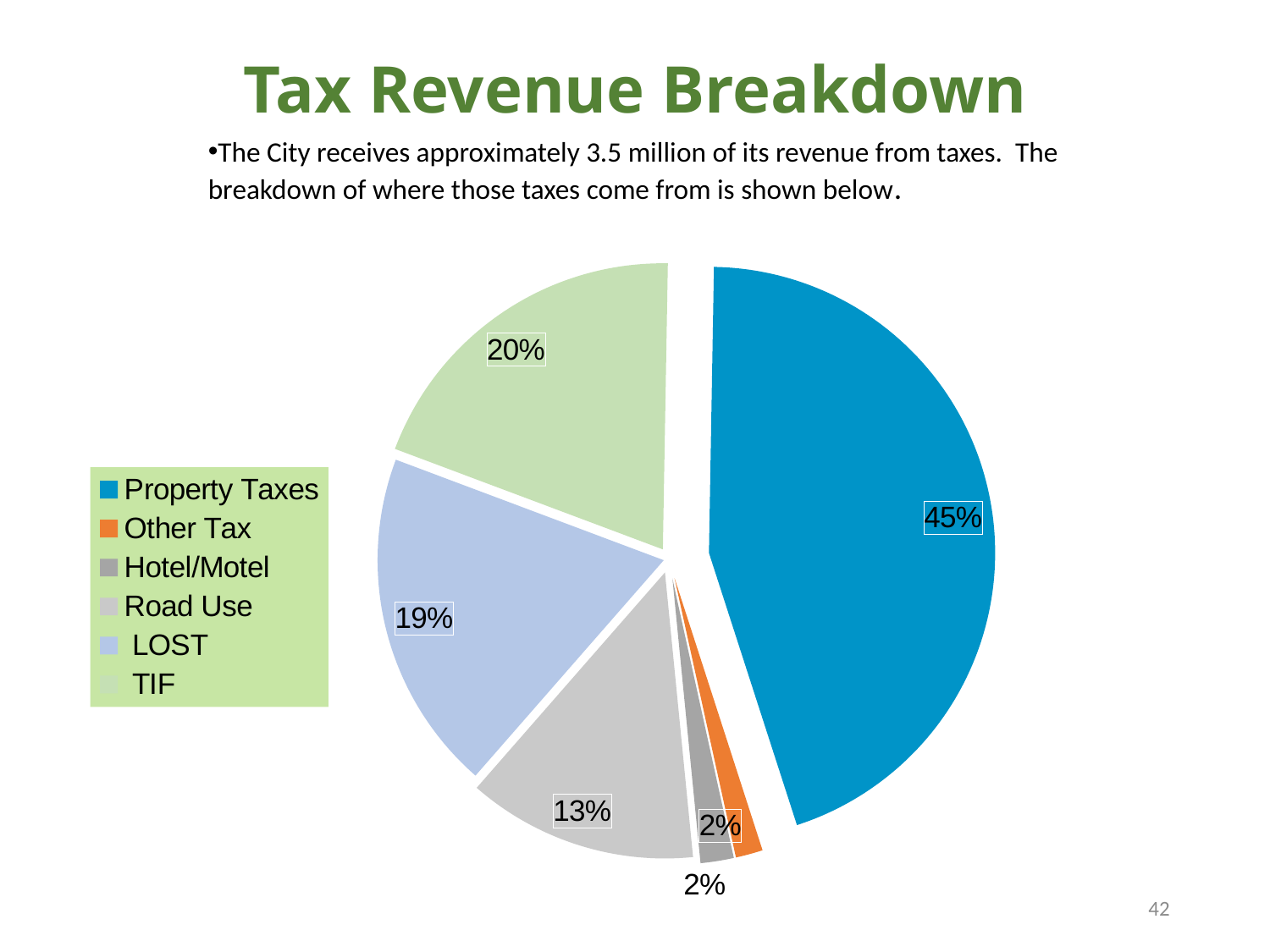
Which has a larger share, TIF or LOST? TIF Which category has the largest share of the pie? Property Taxes How many categories are shown in the pie chart? 6 How many percentage points larger is the Property Taxes share than the TIF share? 25 percentage points What kind of chart is shown on the slide? pie chart What percentage of tax revenue comes from Hotel/Motel? 2% What share of tax revenue comes from Property Taxes? 45% What share of the pie does Road Use represent? 13% How many entries does the legend list? 6 What percentage of the pie is TIF? 20% What percentage of tax revenue comes from LOST? 19% What is the title of the slide containing the pie chart? Tax Revenue Breakdown